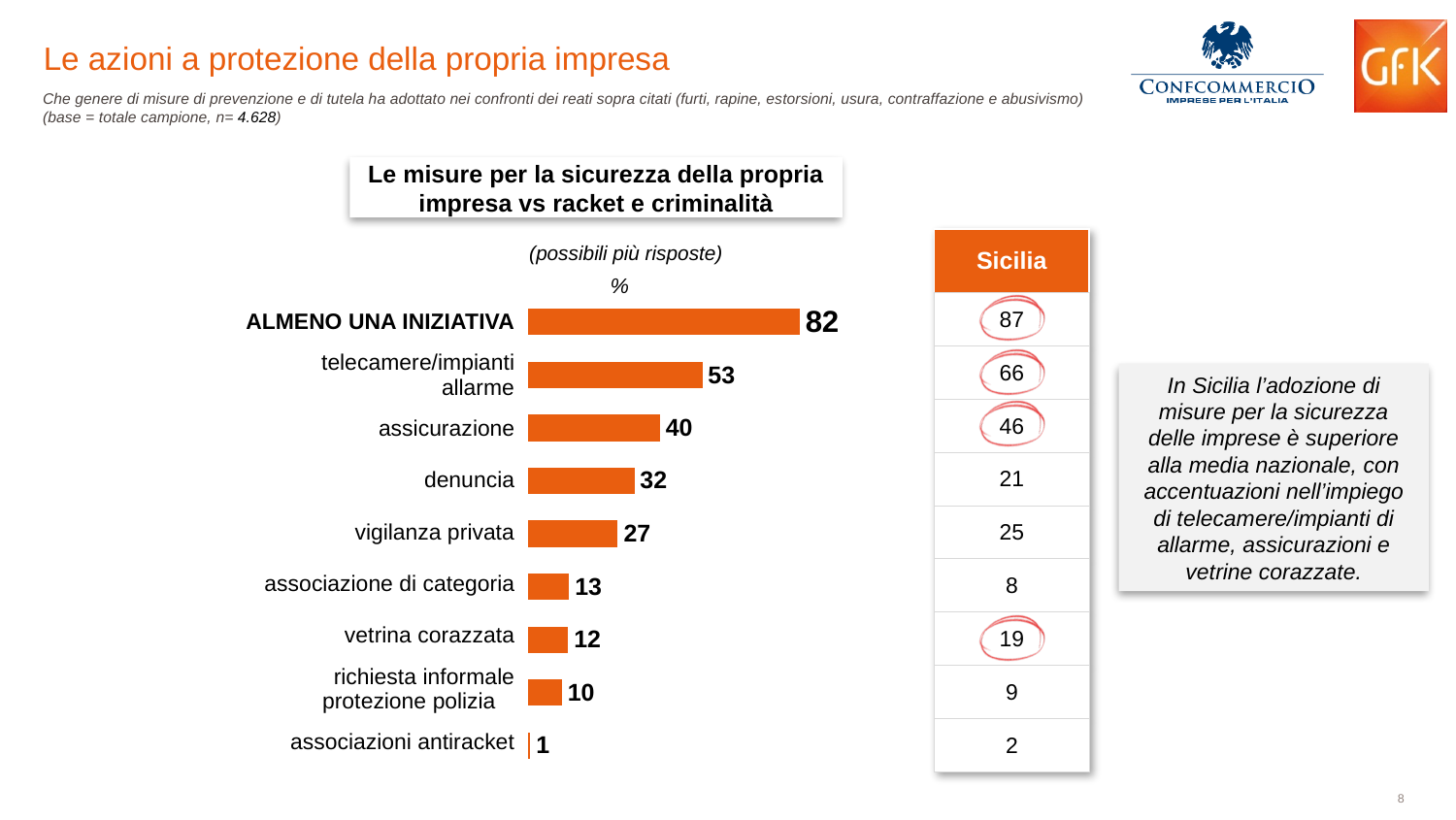
Which category has the highest value in the bar chart? ALMENO UNA INIZIATIVA What is the title of the chart? Le misure per la sicurezza della propria impresa vs racket e criminalità What is the difference between the Sicilia value and the bar chart value for "ALMENO UNA INIZIATIVA"? 5 What kind of chart is shown on the slide? bar chart What is the value for "vetrina corazzata" in the bar chart? 12 What is the value for "denuncia" in the bar chart? 32 Which is larger, the value for "associazione di categoria" or the value for "richiesta informale protezione polizia"? associazione di categoria What is the difference between the values for "assicurazione" and "vigilanza privata"? 13 What is the value for "telecamere/impianti allarme" in the bar chart? 53 In the Sicilia column next to the chart, what is the value for "telecamere/impianti allarme"? 66 Which category has the lowest value in the bar chart? associazioni antiracket How many categories are shown in the bar chart? 9